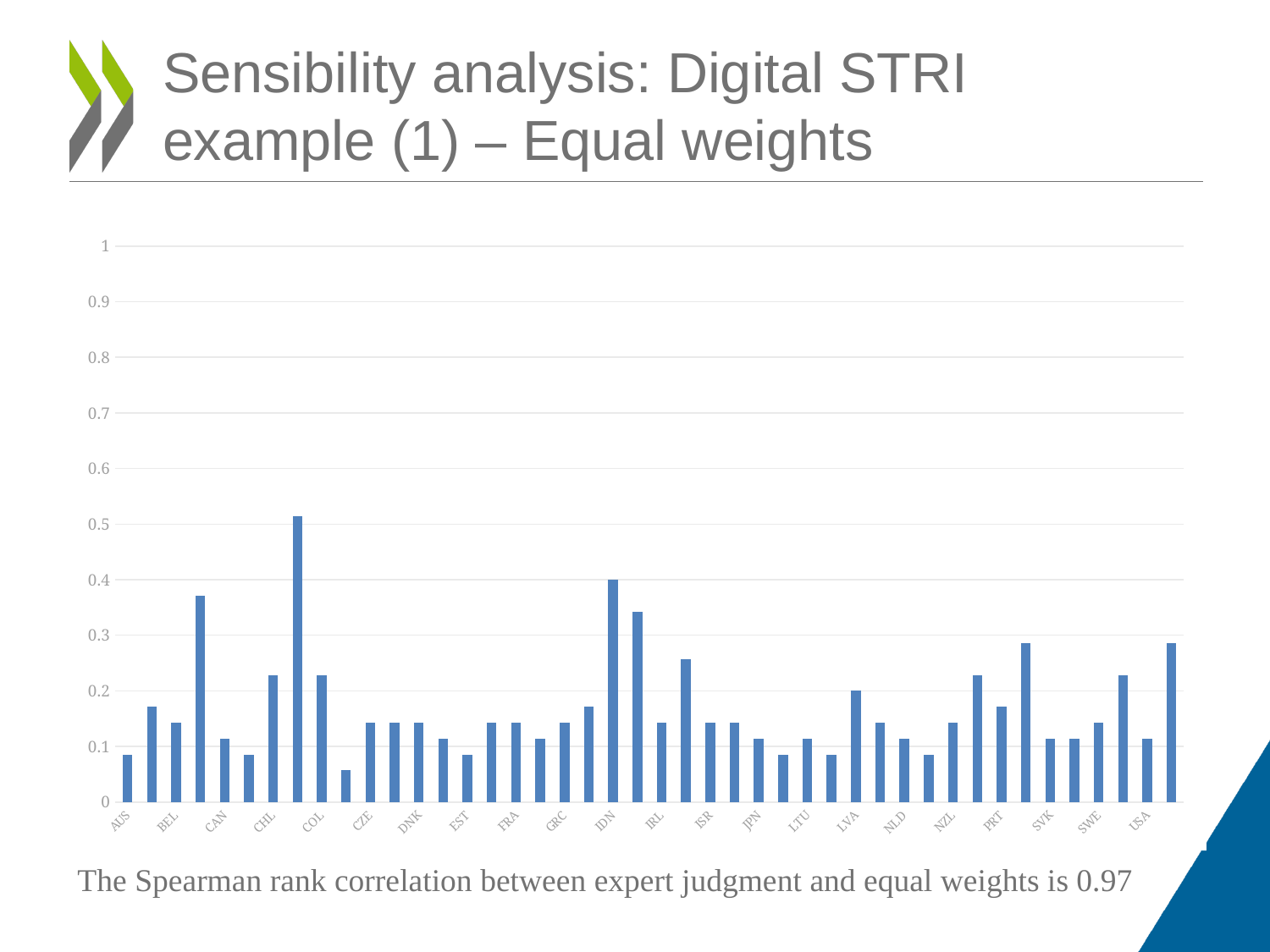
Is the value for EST greater or less than 0.1? less Which has the larger value, IDN or COL? IDN Which has the larger value, IRL or IDN? IDN Is the value for IDN greater or less than 0.3? greater Is the value for AUS greater or less than 0.1? less What kind of chart is shown on the slide? bar chart Which has the larger value, CAN or CHL? CHL What is the highest value shown on the vertical axis? 1 What colour are the bars in the chart? blue